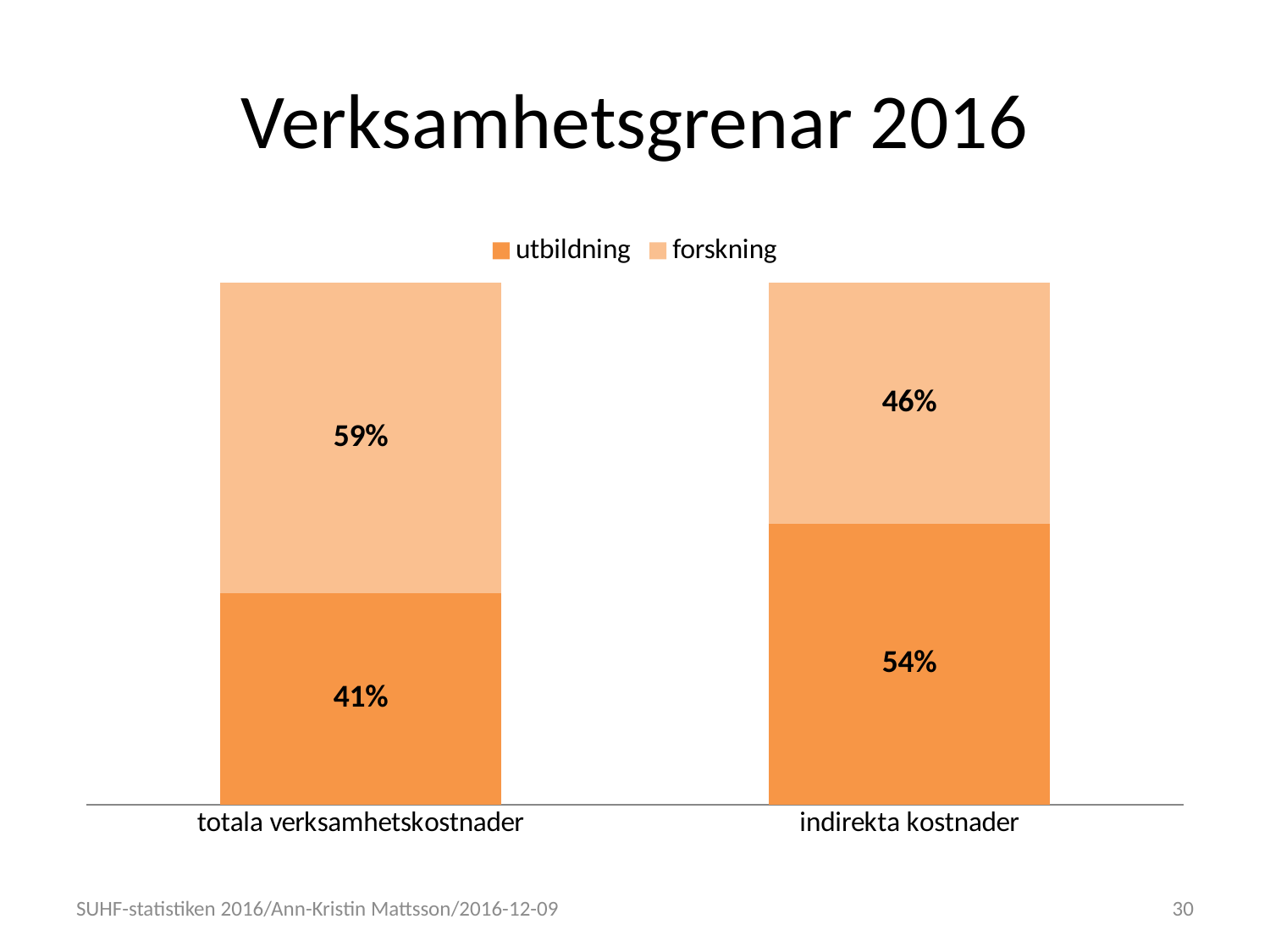
Is the utbildning value larger for totala verksamhetskostnader or for indirekta kostnader? indirekta kostnader How many series does the legend list? 2 How many categories are shown on the x axis? 2 What is the difference between the utbildning values for indirekta kostnader and totala verksamhetskostnader? 13% What kind of chart is shown on the slide? stacked bar chart Which category has the higher value for utbildning? indirekta kostnader What is the value for forskning in the indirekta kostnader bar? 46% Which category has the lower value for forskning? indirekta kostnader What is the value for utbildning in the totala verksamhetskostnader bar? 41% What is the difference between the forskning and utbildning values for totala verksamhetskostnader? 18% What is the value for forskning in the totala verksamhetskostnader bar? 59% What is the value for utbildning in the indirekta kostnader bar? 54%